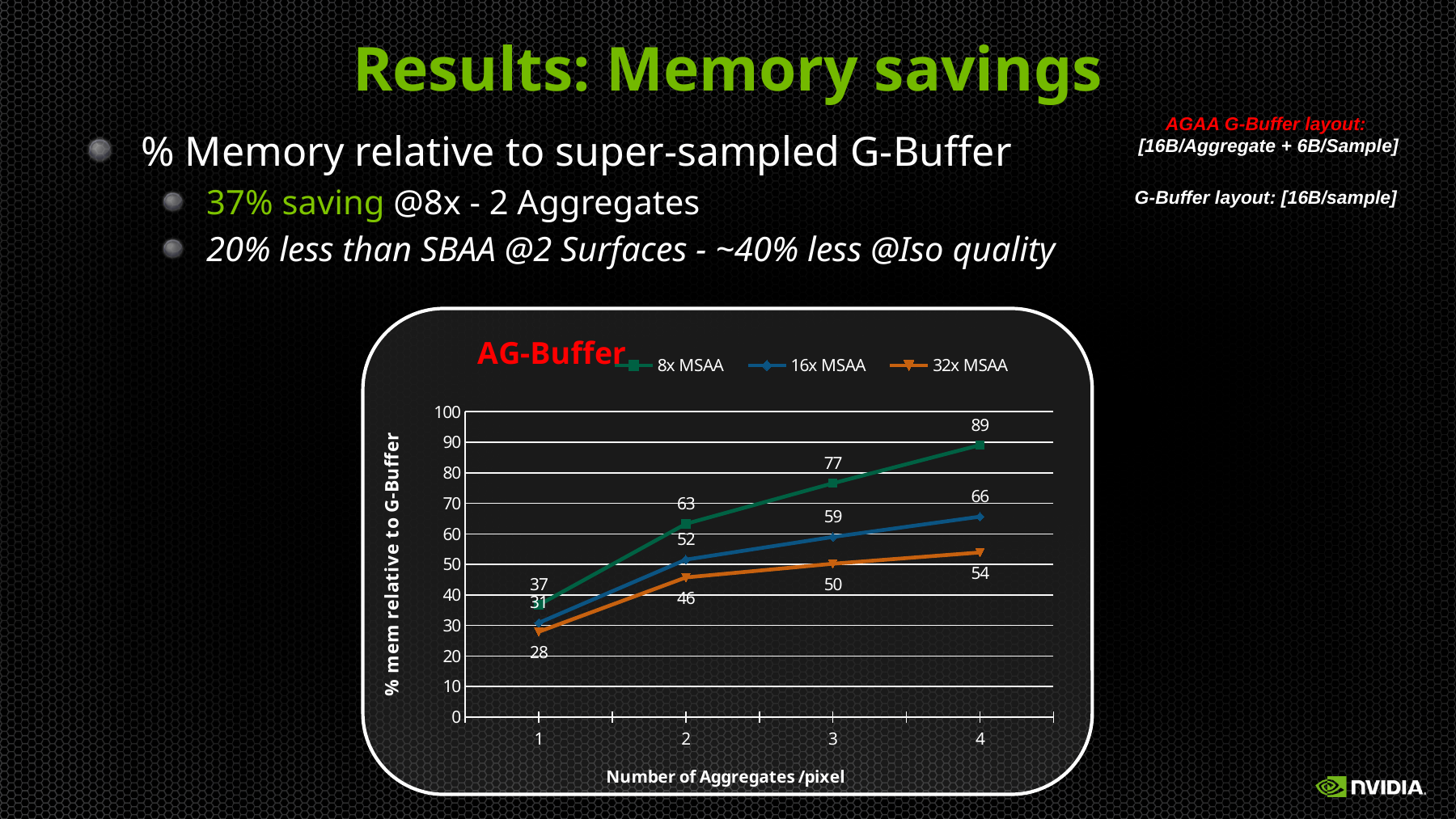
What is the value for 8x MSAA at 4 aggregates per pixel? 89 Which series has the lowest value at 4 aggregates per pixel? 32x MSAA How many points are plotted along the x axis for each series? 4 Which is larger: the 16x MSAA value at 2 aggregates per pixel or the 32x MSAA value at 4 aggregates per pixel? 32x MSAA at 4 aggregates per pixel What is the label of the chart's y axis? % mem relative to G-Buffer What is the value for 32x MSAA at 1 aggregate per pixel? 28 What is the value for 16x MSAA at 3 aggregates per pixel? 59 What is the difference between the 8x MSAA and 16x MSAA values at 4 aggregates per pixel? 23 How many series does the chart legend list? 3 What type of chart is shown on the slide? line chart Which series has the highest value at 2 aggregates per pixel? 8x MSAA Do the 8x MSAA values rise or fall as the number of aggregates per pixel increases? rise